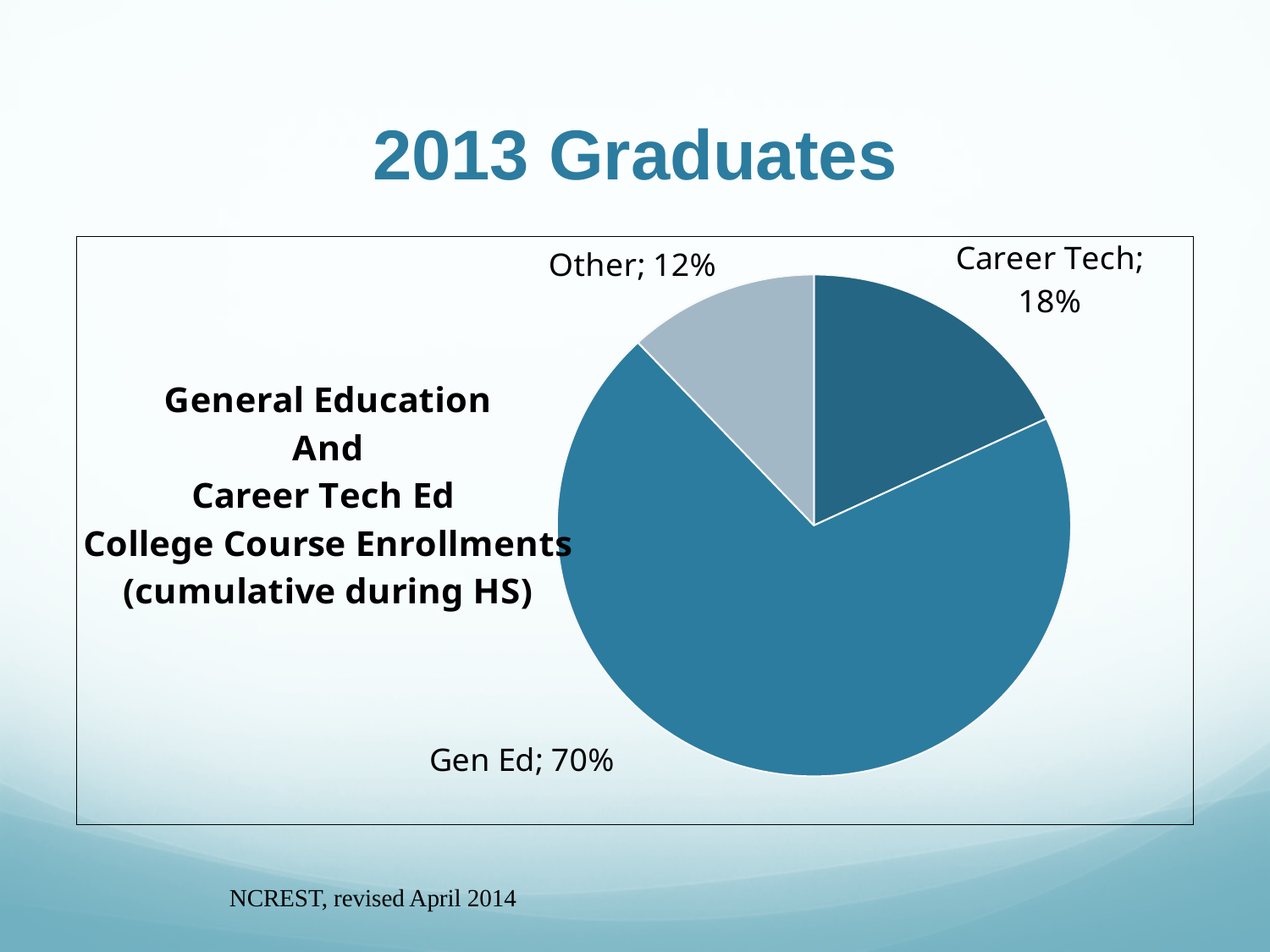
What kind of chart is shown on the slide? pie chart What is the difference in percentage points between Career Tech and Other? 6 What share of college course enrollments is Career Tech? 18% What share of college course enrollments is Gen Ed? 70% What is the title of the slide? 2013 Graduates Which slice of the pie is the lightest in colour? Other Which is larger, the Career Tech slice or the Other slice? Career Tech Which category has the largest slice of the pie? Gen Ed Which category has the smallest slice of the pie? Other How many slices does the pie chart have? 3 What share of college course enrollments is Other? 12% What is the difference in percentage points between Gen Ed and Career Tech? 52